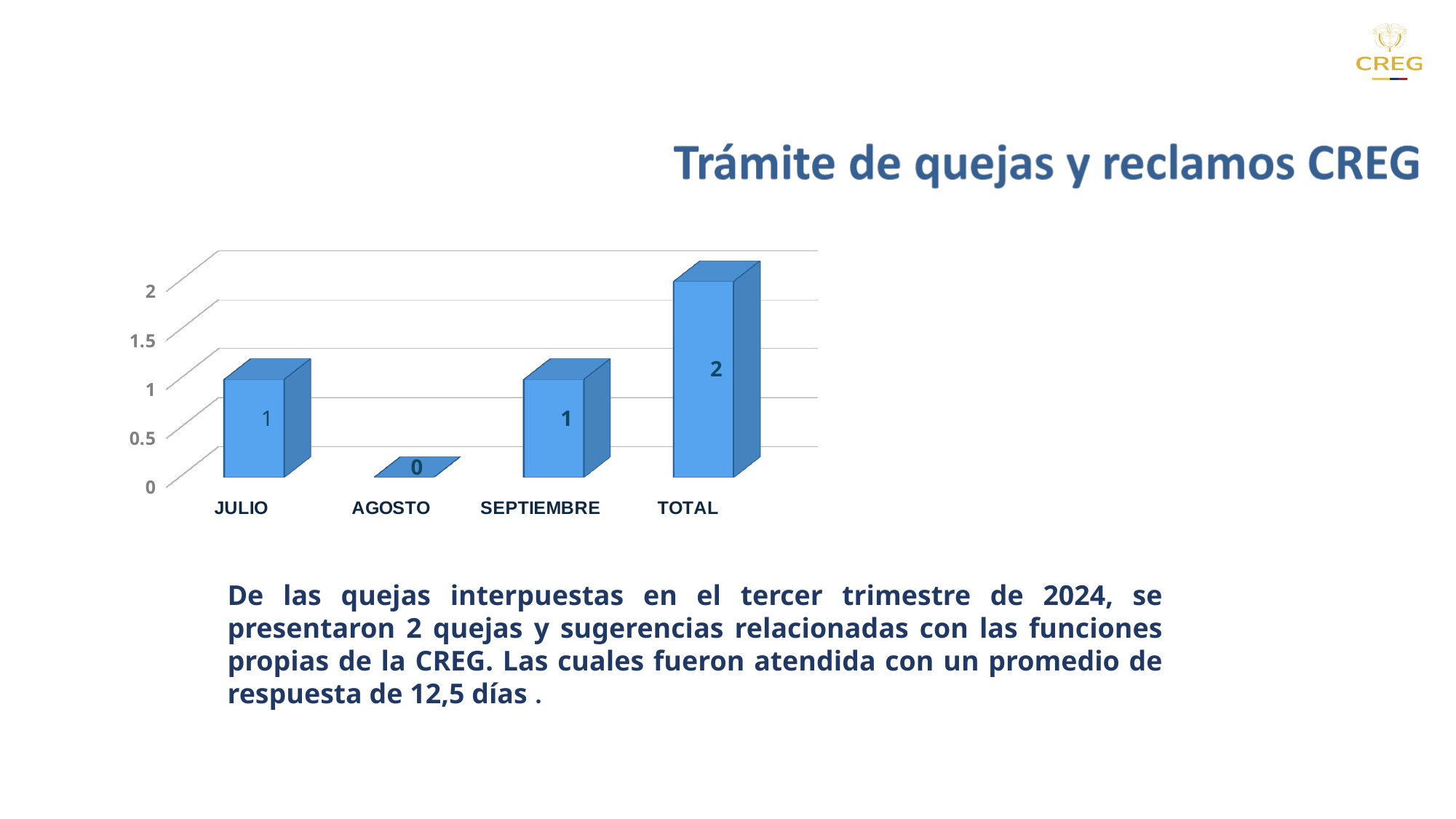
What is the title of the slide containing the chart? Trámite de quejas y reclamos CREG How many categories are shown on the x axis? 4 What is the value for TOTAL? 2 What is the difference between the values for TOTAL and JULIO? 1 Which is larger, the value for SEPTIEMBRE or the value for AGOSTO? SEPTIEMBRE What kind of chart is shown on the slide? bar chart What is the value for SEPTIEMBRE? 1 Which category has the highest value? TOTAL What is the value for AGOSTO? 0 Is the value for TOTAL greater or less than 1.5? greater What is the value for JULIO? 1 Which category has the lowest value? AGOSTO